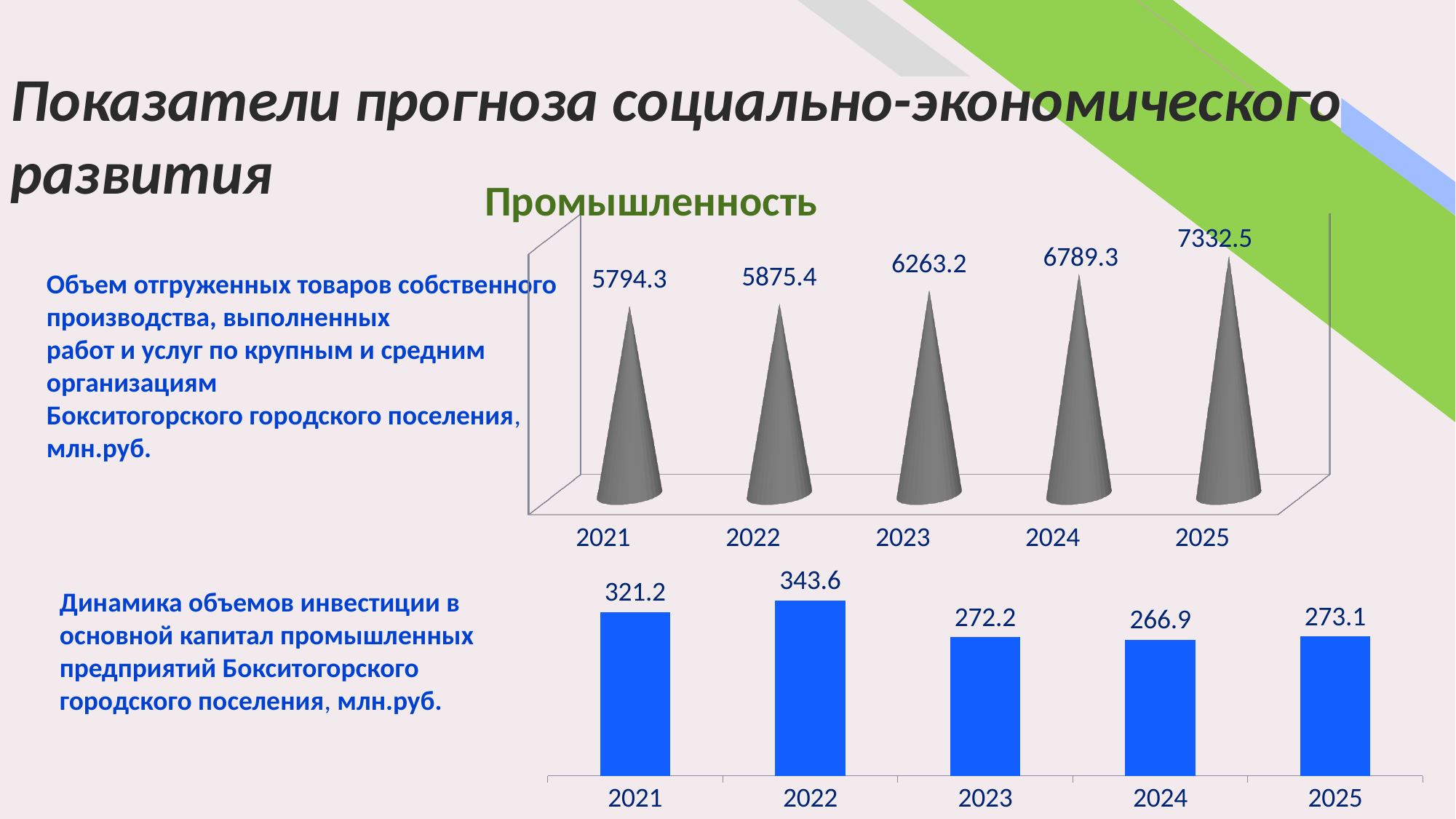
In the bottom chart (investments in fixed capital), what is the value for 2022? 343.6 In the bottom chart (investments in fixed capital), which year has the lowest value? 2024 In the bottom chart (investments in fixed capital), which is larger, the value for 2023 or the value for 2024? 2023 In the top chart (Промышленность), what is the difference between the 2025 and 2021 values? 1538.2 In the top chart (Промышленность), which year has the highest value? 2025 In the top chart (Промышленность), what is the value for 2023? 6263.2 In the top chart (Промышленность), do the values rise or fall from 2021 to 2025? rise In the bottom chart (investments in fixed capital), what is the value for 2024? 266.9 In the bottom chart (investments in fixed capital), what is the difference between the 2022 and 2021 values? 22.4 In the top chart (Промышленность), what is the value for 2021? 5794.3 In the top chart (Промышленность), which year has the lowest value? 2021 How many years are shown in the bottom chart (investments in fixed capital)? 5